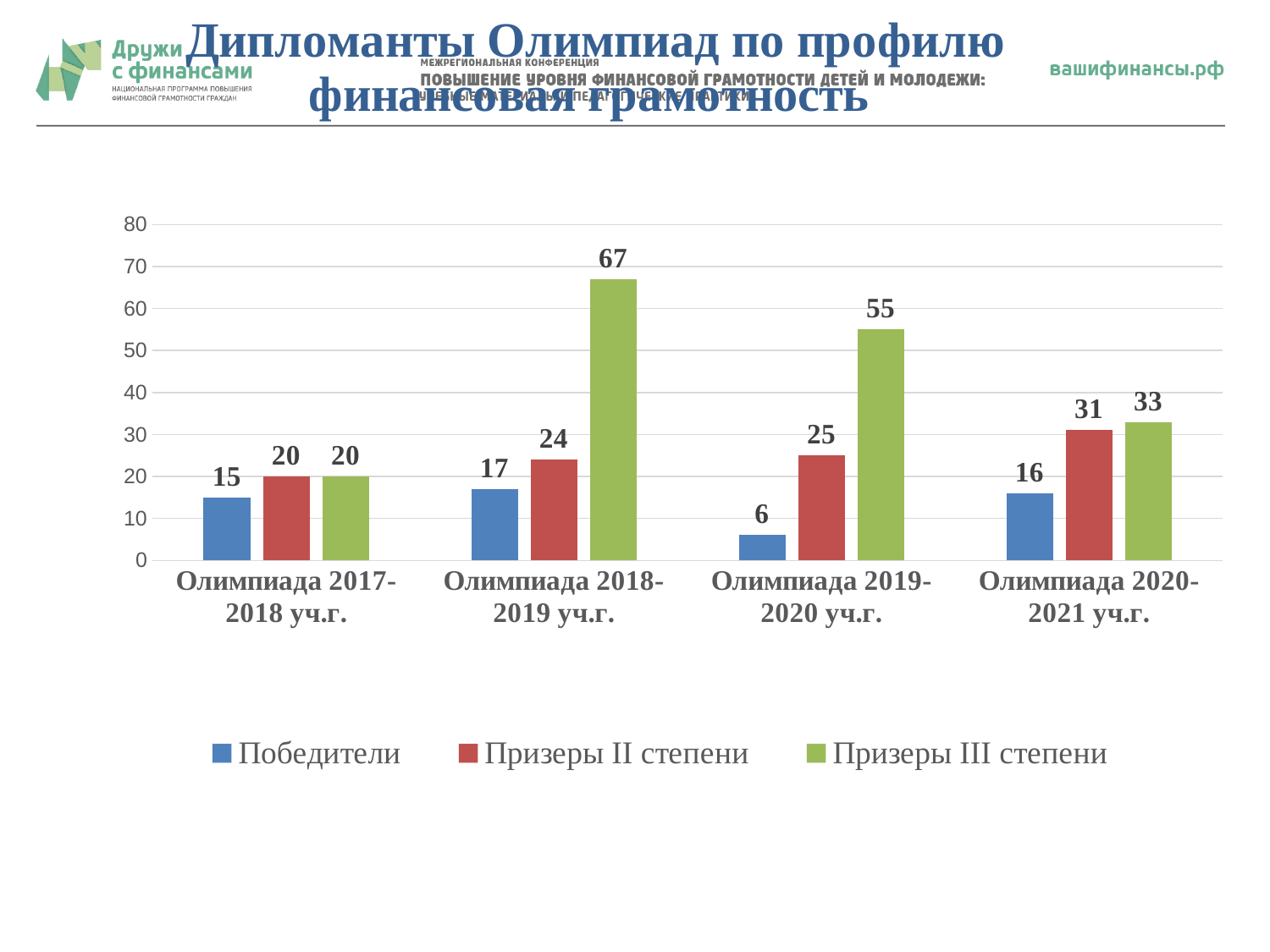
What is the value for Победители in Олимпиада 2019-2020 уч.г.? 6 Which category has the highest value for Призеры III степени? Олимпиада 2018-2019 уч.г. Which category has the lowest value for Победители? Олимпиада 2019-2020 уч.г. Is the value for Призеры III степени in Олимпиада 2019-2020 уч.г. greater or less than 50? greater Which is larger in Олимпиада 2020-2021 уч.г.: Призеры II степени or Призеры III степени? Призеры III степени What is the value for Призеры III степени in Олимпиада 2018-2019 уч.г.? 67 How many series does the legend list? 3 Which colour represents Призеры II степени in the legend? red How many categories are shown on the x axis? 4 What is the value for Призеры II степени in Олимпиада 2020-2021 уч.г.? 31 What kind of chart is shown on the slide? bar chart What is the difference between Призеры III степени and Победители in Олимпиада 2019-2020 уч.г.? 49